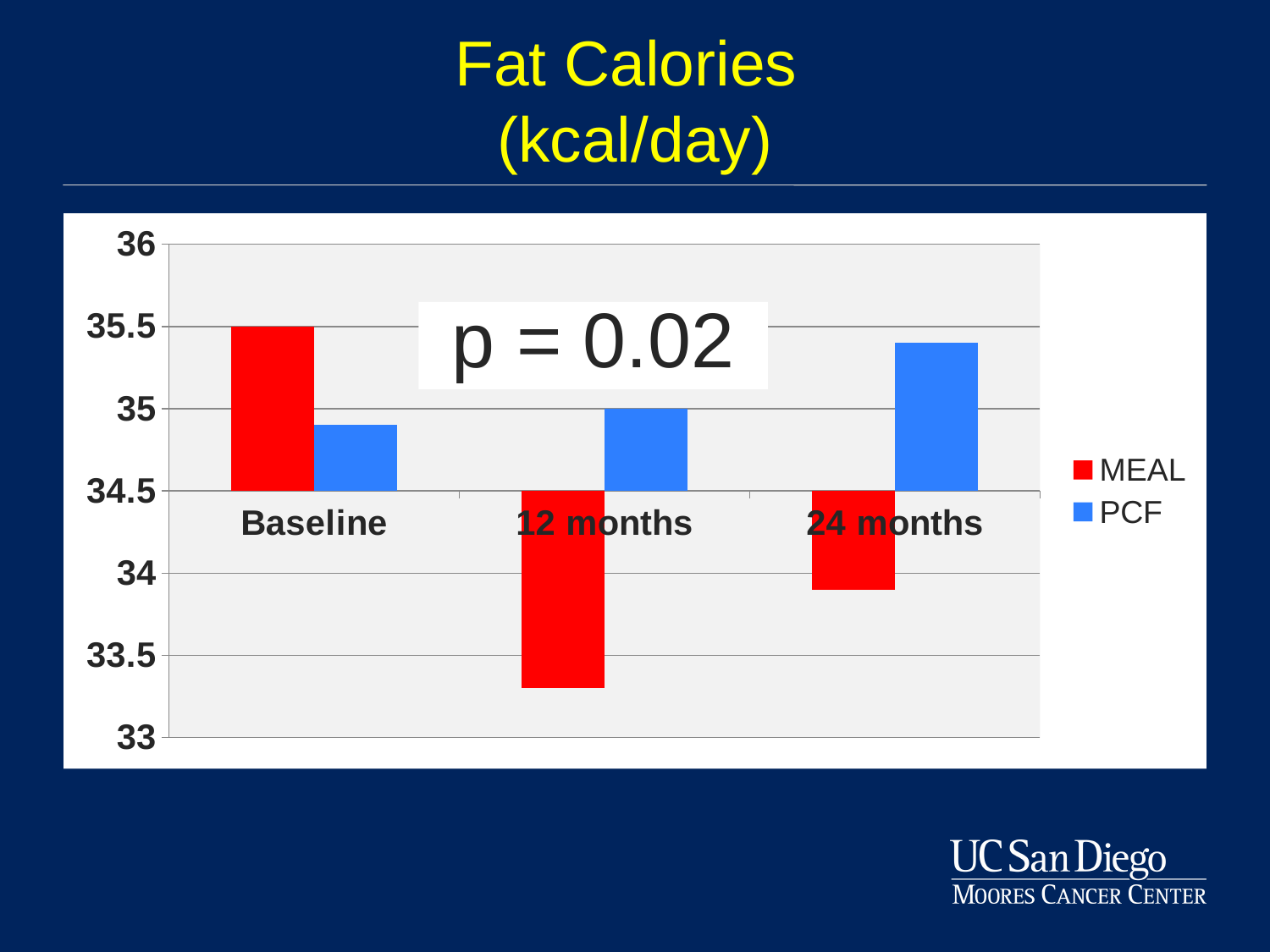
What p-value is displayed on the chart? p = 0.02 At 12 months, which series has the larger value, MEAL or PCF? PCF At which time point is the PCF value highest? 24 months How many categories are shown on the x axis? 3 How many series does the legend list? 2 At which time point is the MEAL value lowest? 12 months At which time point is the MEAL value highest? Baseline Is the MEAL value at 12 months greater or less than 33.5? less What kind of chart is shown on the slide? Bar chart What is the MEAL value at Baseline? 35.5 Is the PCF value at 24 months greater or less than 35? greater What is the PCF value at 12 months? 35